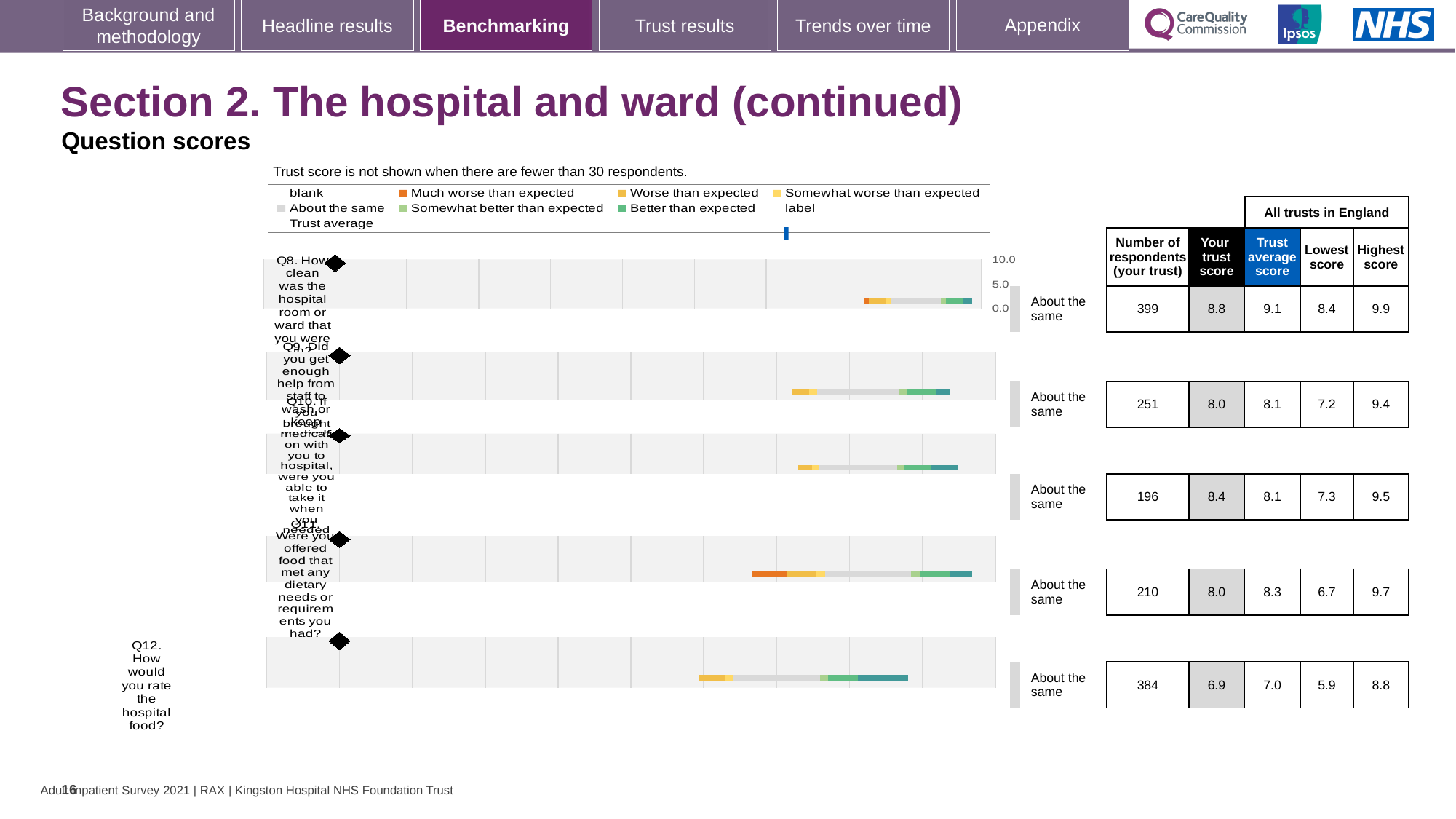
What is the highest score across all trusts in England for Q11 (Were you offered food that met any dietary needs)? 9.7 What is the difference between the trust average score and 'Your trust score' for Q12? 0.1 What is the 'Your trust score' for Q8 (How clean was the hospital room or ward)? 8.8 What benchmark category is shown for every question on this slide? About the same What is the trust average score for Q10 (medication brought with you to hospital)? 8.1 Which has the larger 'Your trust score', Q8 or Q9? Q8 How many questions are plotted on the chart? 5 How many respondents (your trust) are shown for Q12 (How would you rate the hospital food)? 384 Which question has the highest number of respondents (your trust)? Q8 What is the difference between the highest score and the lowest score for Q11? 3.0 What is the lowest score across all trusts in England for Q9 (Did you get enough help from staff to wash or keep yourself clean)? 7.2 Which question has the lowest 'Your trust score'? Q12